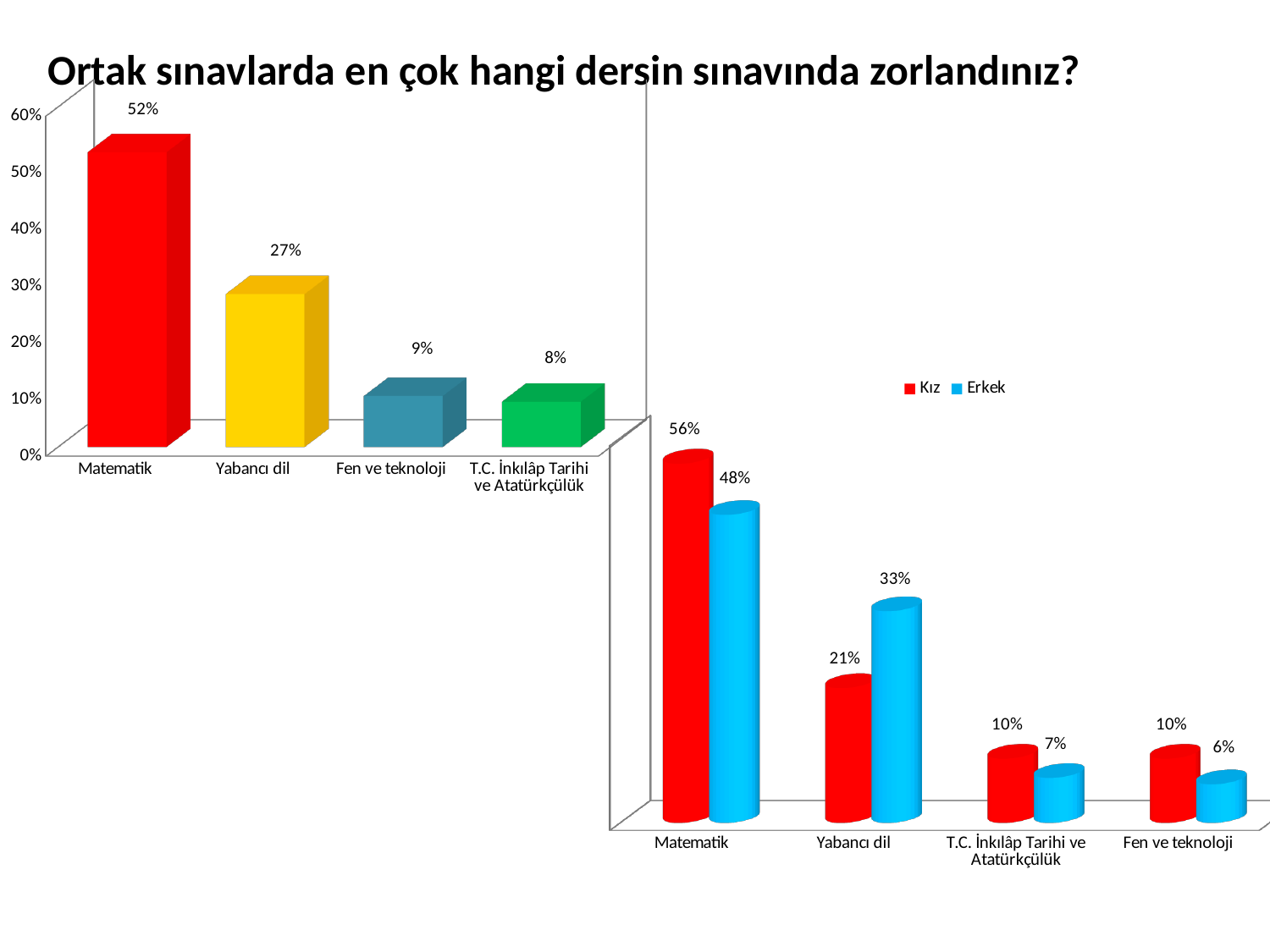
In the bottom-right chart, which is larger for Yabancı dil, Kız or Erkek? Erkek In the bottom-right chart, what is the difference between the Kız and Erkek values for Matematik? 8% In the bottom-right chart, what is the Erkek value for Yabancı dil? 33% In the top-left chart, what is the value for Yabancı dil? 27% What kind of chart is the top-left chart? Bar chart In the bottom-right chart, what is the Erkek value for Fen ve teknoloji? 6% In the top-left chart, what is the difference between Matematik and Yabancı dil? 25% In the bottom-right chart, how many series does the legend list? 2 In the top-left chart, what is the value for Matematik? 52% In the bottom-right chart, what is the Kız value for Matematik? 56% In the top-left chart, which category has the lowest value? T.C. İnkılâp Tarihi ve Atatürkçülük In the top-left chart, how many categories are shown? 4